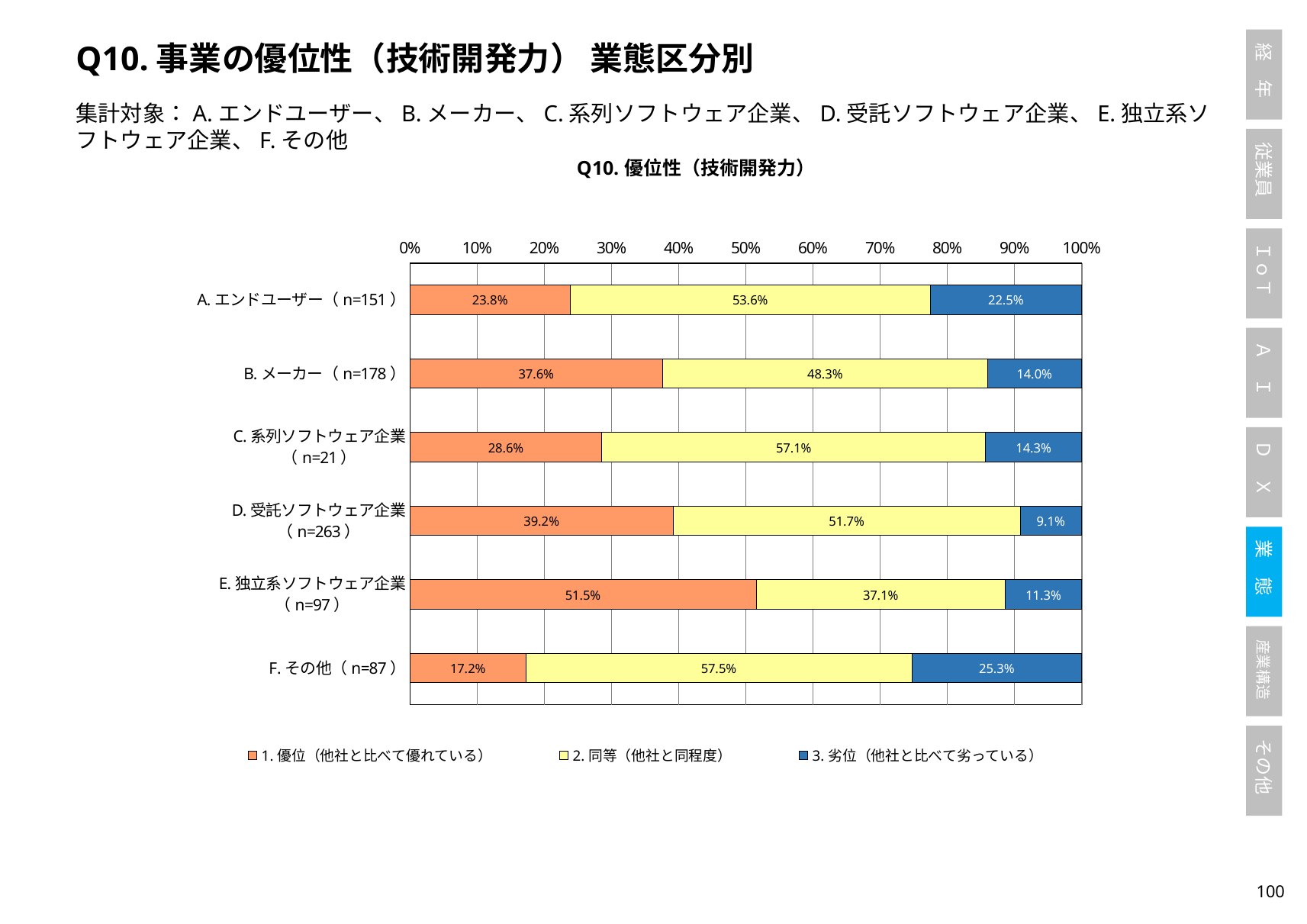
Which category has the lowest value for 1. 優位? F. その他 (n=87) Which has the larger 1. 優位 value, B. メーカー or D. 受託ソフトウェア企業? D. 受託ソフトウェア企業 What is the difference between the 1. 優位 values for E. 独立系ソフトウェア企業 and A. エンドユーザー? 27.7 percentage points Which category has the highest value for 1. 優位? E. 独立系ソフトウェア企業 (n=97) What is the value of 3. 劣位 for D. 受託ソフトウェア企業 (n=263)? 9.1% How many series does the legend list? 3 What kind of chart is shown on the slide? Stacked horizontal bar chart What is the value of 2. 同等 for B. メーカー (n=178)? 48.3% What is the title of the chart? Q10. 優位性（技術開発力） What is the value of 1. 優位 for A. エンドユーザー (n=151)? 23.8% How many business-type categories are plotted in the chart? 6 Which category has the highest value for 3. 劣位? F. その他 (n=87)